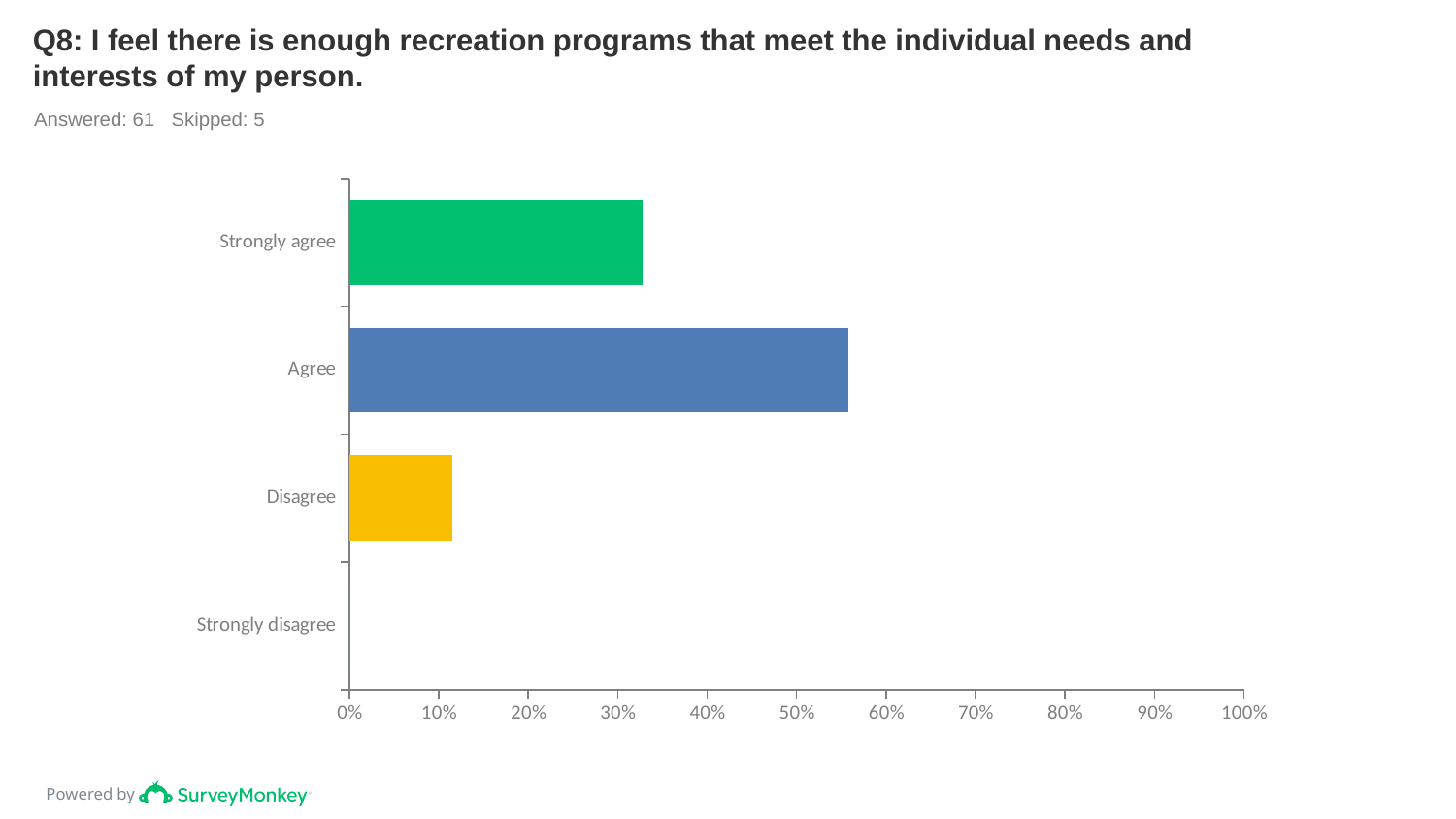
How many respondents answered this question, according to the slide? 61 Which response category has the lowest value? Strongly disagree Is the value for Strongly agree greater or less than 30%? greater Is the value for Agree greater or less than 50%? greater Which is larger, the value for Agree or the value for Strongly agree? Agree How many response categories are shown on the chart? 4 What kind of chart is shown on the slide? bar chart Is the value for Strongly agree greater or less than 40%? less What is the highest value shown on the horizontal axis? 100% Which response category has the highest value? Agree Which is larger, the value for Strongly agree or the value for Disagree? Strongly agree